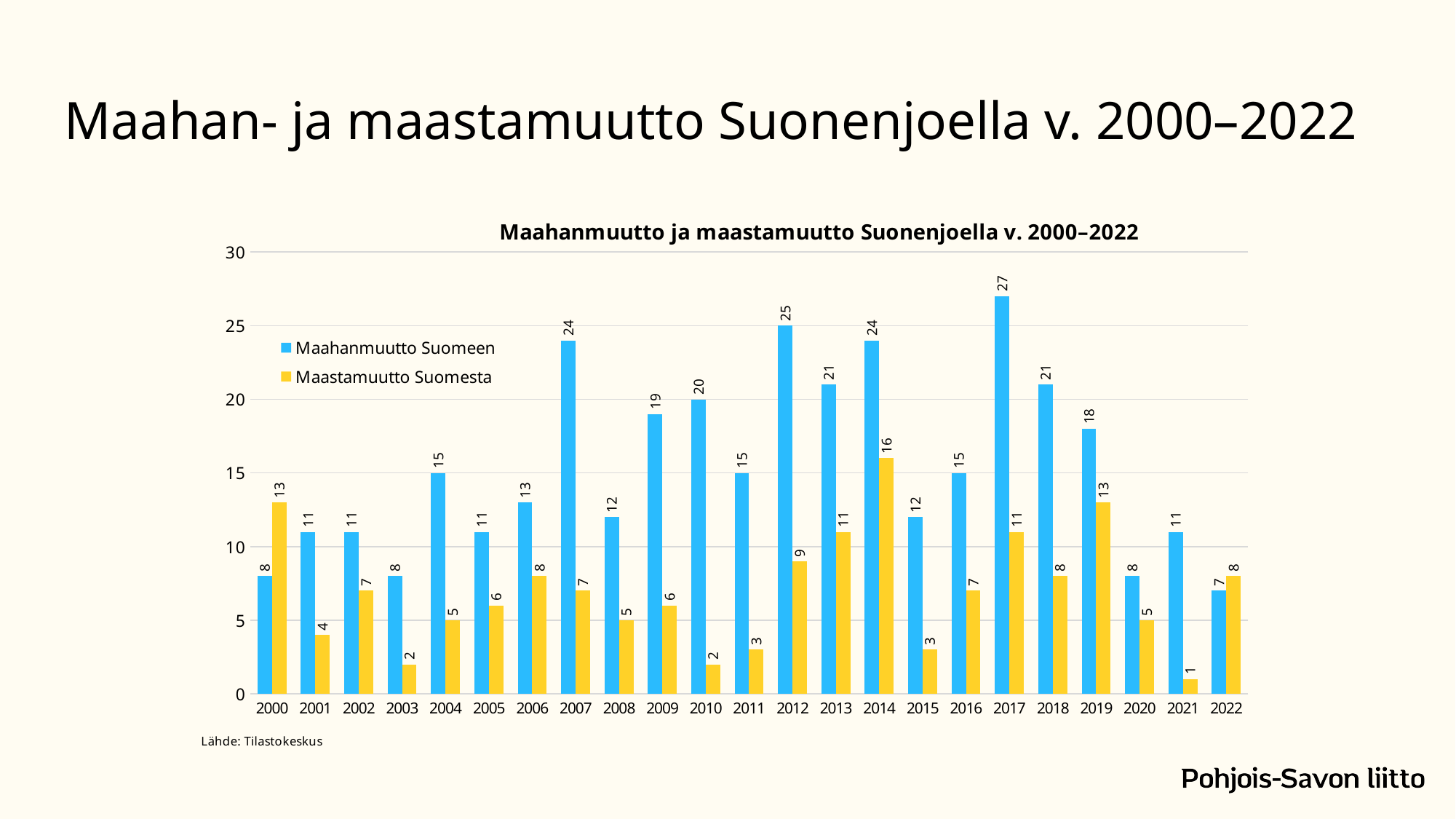
How many years are shown on the x axis? 23 What kind of chart is shown on the slide? Bar chart Which year has the highest value for Maastamuutto Suomesta? 2014 What is the title of the chart? Maahanmuutto ja maastamuutto Suonenjoella v. 2000–2022 What is the value of Maahanmuutto Suomeen in 2017? 27 What is the difference between Maahanmuutto Suomeen and Maastamuutto Suomesta in 2012? 16 What is the value of Maahanmuutto Suomeen in 2007? 24 Which is larger in 2022, Maahanmuutto Suomeen or Maastamuutto Suomesta? Maastamuutto Suomesta What is the value of Maastamuutto Suomesta in 2014? 16 Which year has the lowest value for Maastamuutto Suomesta? 2021 How many series does the legend list? 2 Which year has the highest value for Maahanmuutto Suomeen? 2017